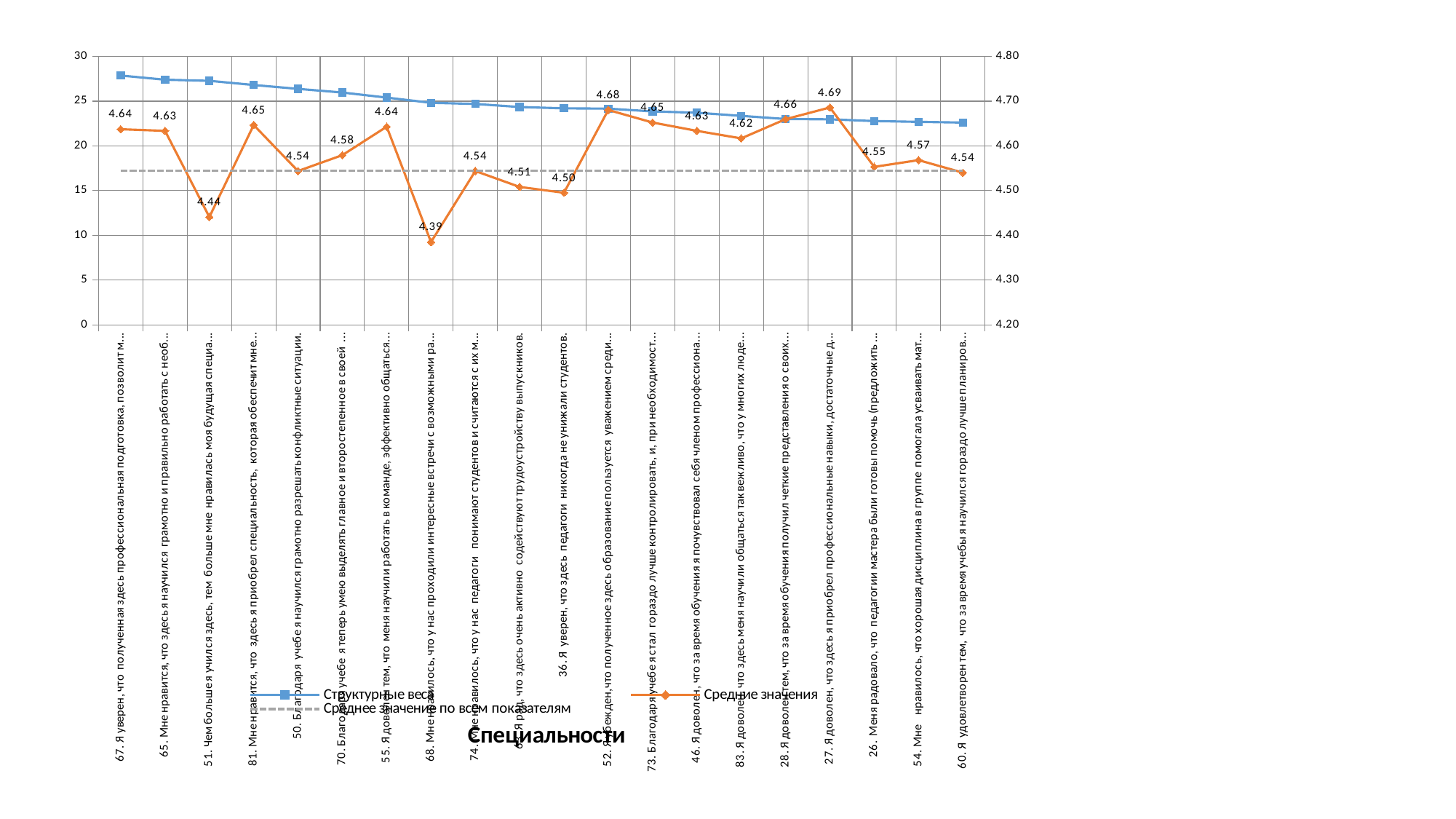
What is the value of the 'Средние значения' series for item 27 (Я доволен, что здесь я приобрел профессиональные навыки...)? 4.69 What is the title of the x axis? Специальности Is the 'Структурные веса' value for the first item (67. Я уверен, что полученная здесь профессиональная подготовка...) greater or less than 25 on the left axis? greater Which item has the highest value in the 'Средние значения' series? 27. Я доволен, что здесь я приобрел профессиональные навыки... In the 'Средние значения' series, which has the larger value: item 51 (Чем больше я учился здесь...) or item 81 (Мне нравится, что здесь я приобрел специальность...)? 81. Мне нравится, что здесь я приобрел специальность... What is the value of the 'Средние значения' series for item 52 (Я убежден, что полученное здесь образование пользуется уважением...)? 4.68 What is the value of the 'Средние значения' series for item 68 (Мне нравилось, что у нас проходили интересные встречи...)? 4.39 What kind of chart is shown on the slide? line chart Which item has the lowest value in the 'Средние значения' series? 68. Мне нравилось, что у нас проходили интересные встречи... How many entries does the legend list? 3 What is the difference between the highest (4.69) and lowest (4.39) values of the 'Средние значения' series? 0.30 Does the 'Структурные веса' series rise or fall from left to right along the x axis? fall